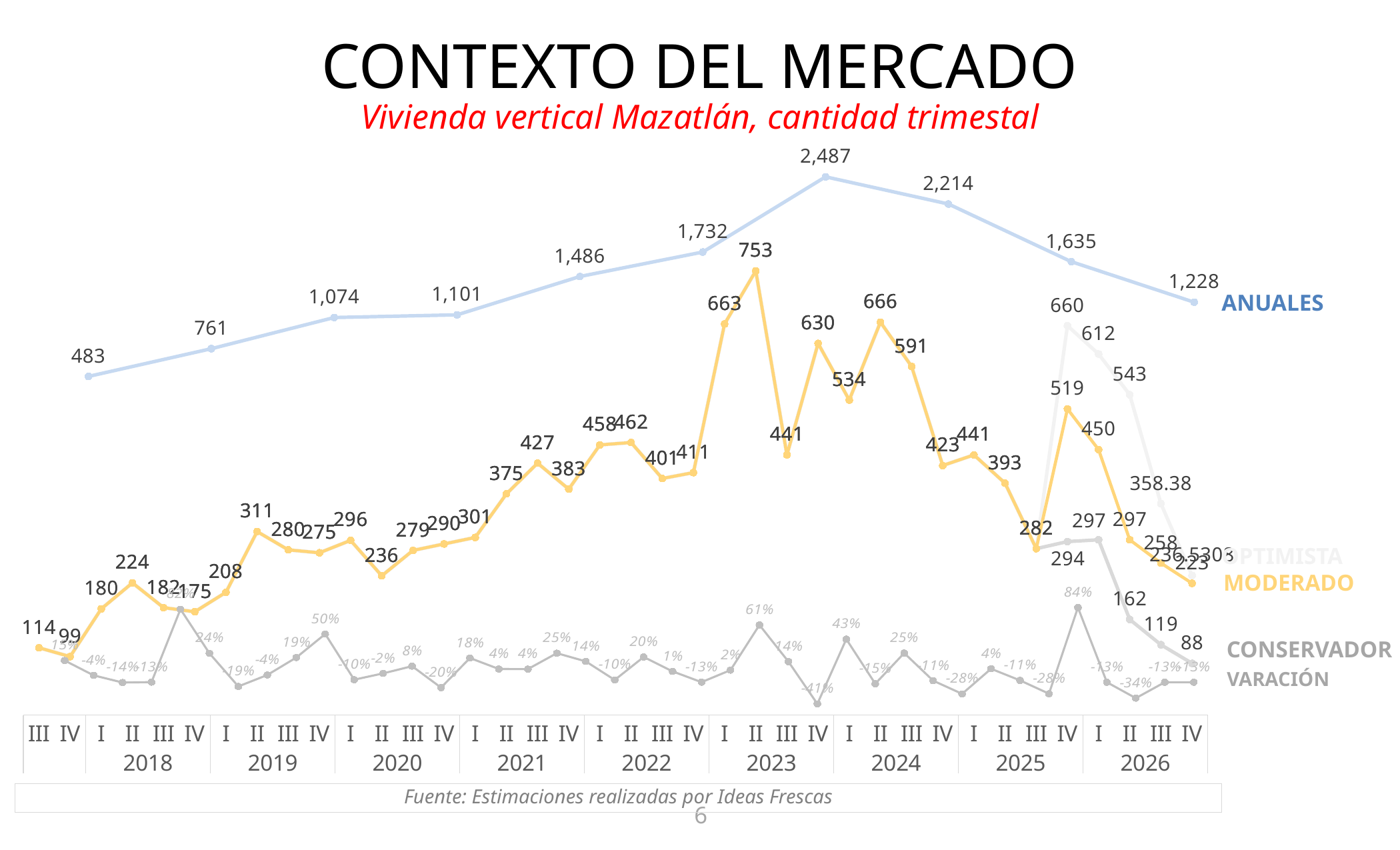
What is the ANUALES value for 2026? 1,228 Does the ANUALES line rise or fall from 2023 to 2026? fall What is the lowest value on the ANUALES line? 483 What is the CONSERVADOR value for quarter IV of 2026? 88 Which is larger, the ANUALES value for 2022 or for 2025? 2022 What is the MODERADO value for quarter II of 2019? 311 What is the difference between the ANUALES values for 2023 and 2024? 273 What is the ANUALES value for 2024? 2,214 What is the highest value on the MODERADO line? 753 How many series does the chart's legend list? 5 What is the highest value on the ANUALES line? 2,487 What kind of chart is shown on the slide? line chart